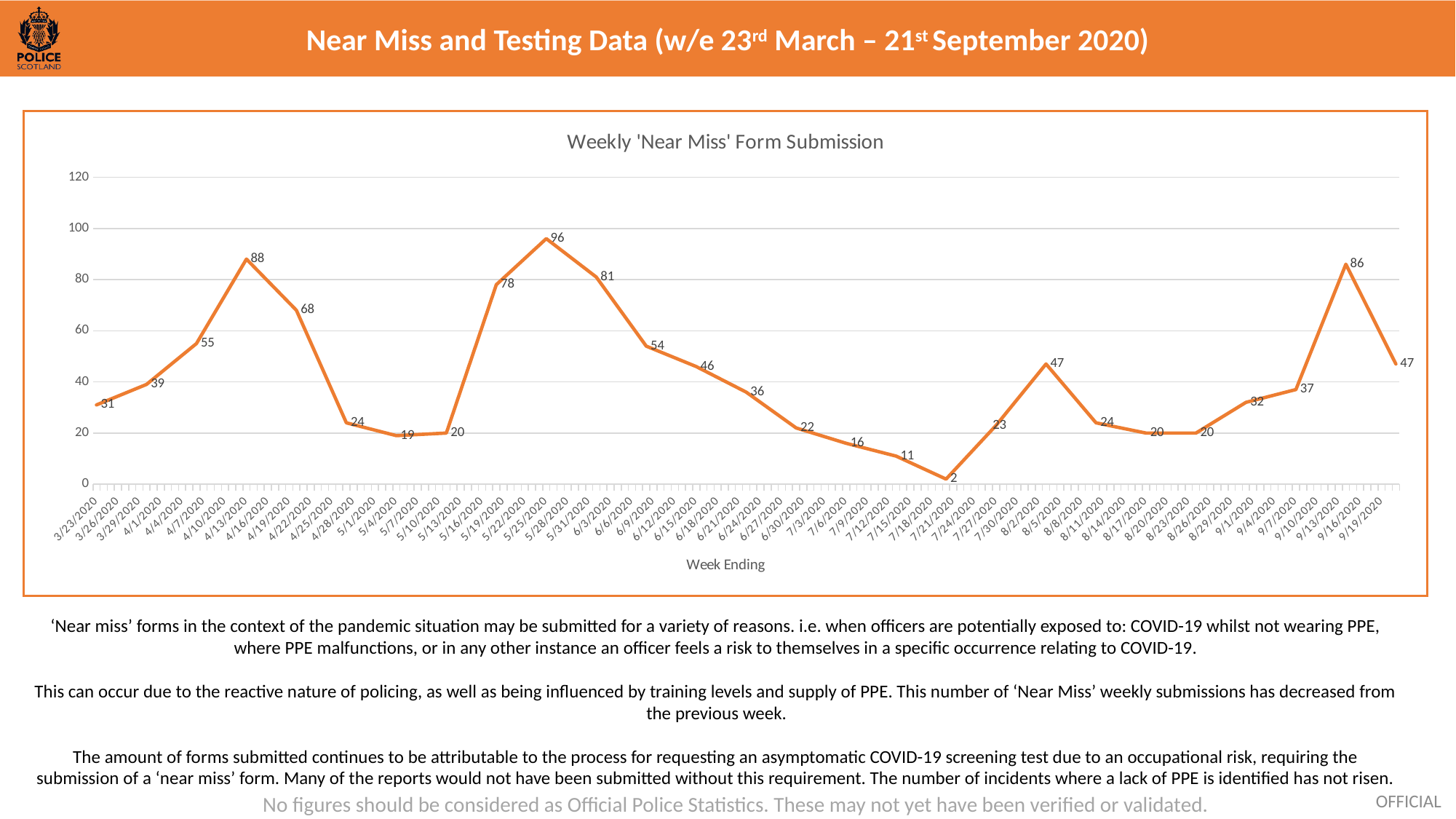
What is the value of the last data point on the chart? 47 Is the highest value on the chart greater or less than 80? greater What is the value of the first data point on the chart (week ending 3/23/2020)? 31 Which is larger: the first peak of 88 in April or the peak of 96 in May? 96 What is the title of the chart? Weekly 'Near Miss' Form Submission What kind of chart is shown on the slide? line chart What is the lowest weekly value plotted on the chart? 2 What is the highest weekly value plotted on the chart? 96 What is the difference between the highest value (96) and the lowest value (2) on the chart? 94 How many data points are plotted on the line? 27 What is the label of the x axis? Week Ending Do the values rise or fall between the peak of 96 and the low of 2? fall